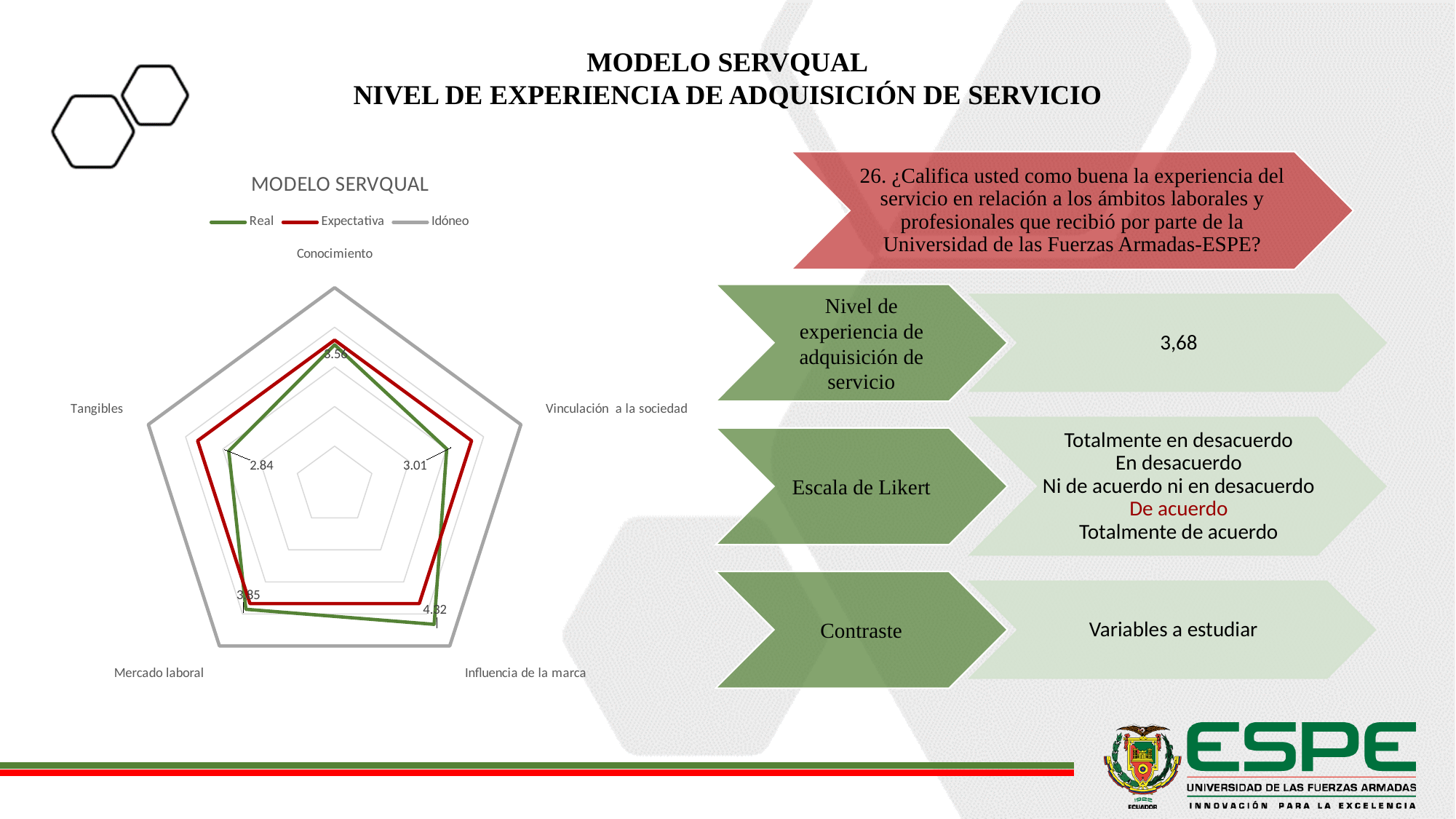
What is the difference between the Real values for Influencia de la marca and Vinculación a la sociedad? 1.31 What is the Real value for Tangibles? 2.84 What is the Real value for Vinculación a la sociedad? 3.01 What kind of chart is shown on the slide? Radar chart How many categories (axes) does the MODELO SERVQUAL radar chart have? 5 How many series does the legend of the MODELO SERVQUAL chart list? 3 Which category has the highest Real value? Influencia de la marca Which category has the lowest Real value? Tangibles For Influencia de la marca, which series has the larger value, Real or Expectativa? Real What are the three series named in the chart legend? Real, Expectativa, Idóneo What is the Real value for Mercado laboral? 3.85 What is the Real value for Influencia de la marca? 4.32